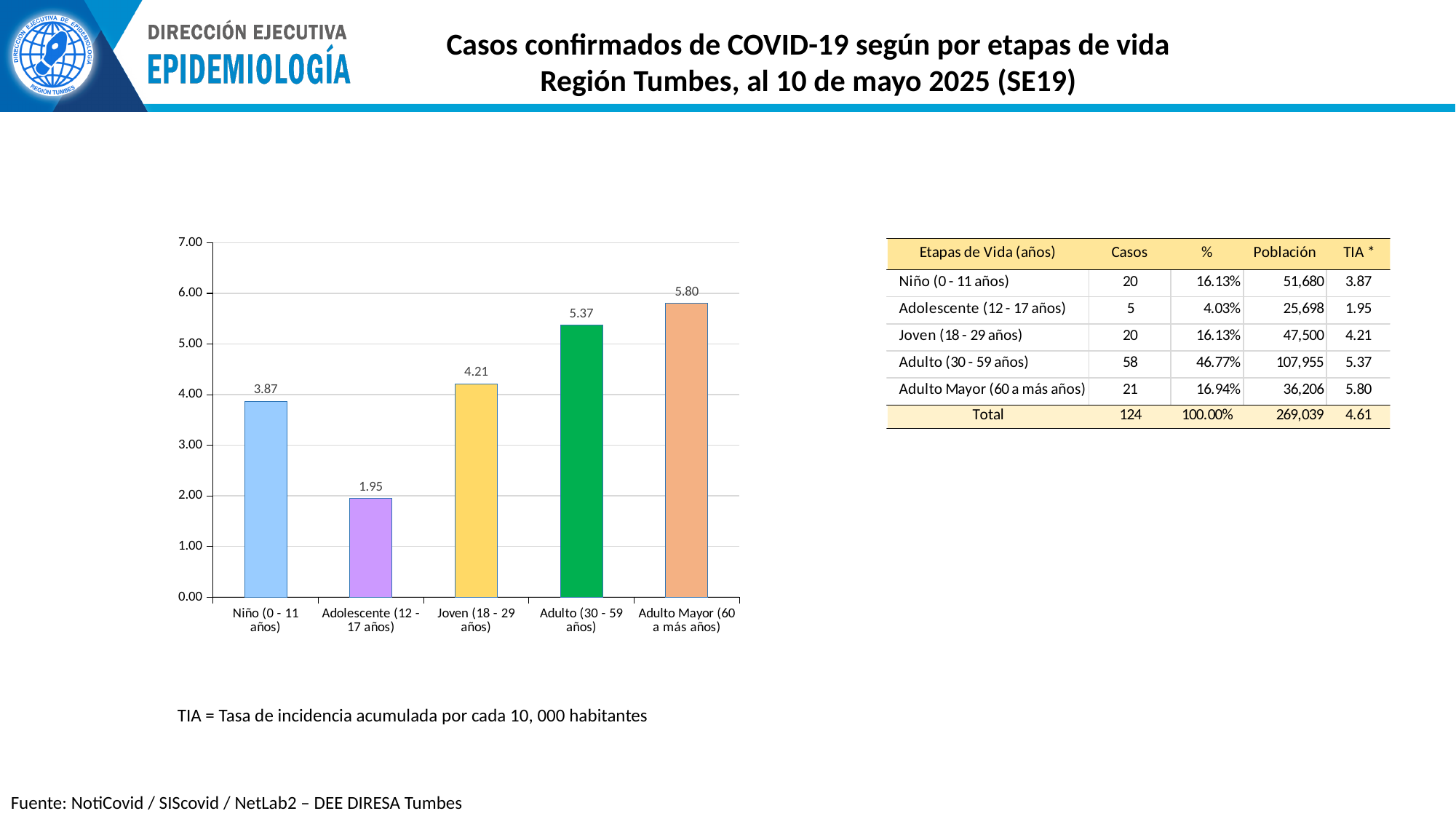
What is the maximum value shown on the y axis of the bar chart? 7.00 Which is larger in the bar chart: the value for Joven (18 - 29 años) or the value for Niño (0 - 11 años)? Joven (18 - 29 años) What is the difference between the values for Adulto Mayor (60 a más años) and Niño (0 - 11 años) in the bar chart? 1.93 What is the value shown for Adolescente (12 - 17 años) in the bar chart? 1.95 What is the value shown for Niño (0 - 11 años) in the bar chart? 3.87 Which category has the highest bar in the chart? Adulto Mayor (60 a más años) Which category has the lowest bar in the chart? Adolescente (12 - 17 años) What kind of chart is shown on the slide? bar chart Is the value for Adulto (30 - 59 años) in the bar chart greater or less than 5.00? greater What colour is the bar for Adulto (30 - 59 años)? green What is the value shown for Adulto (30 - 59 años) in the bar chart? 5.37 How many categories are shown on the x axis of the bar chart? 5